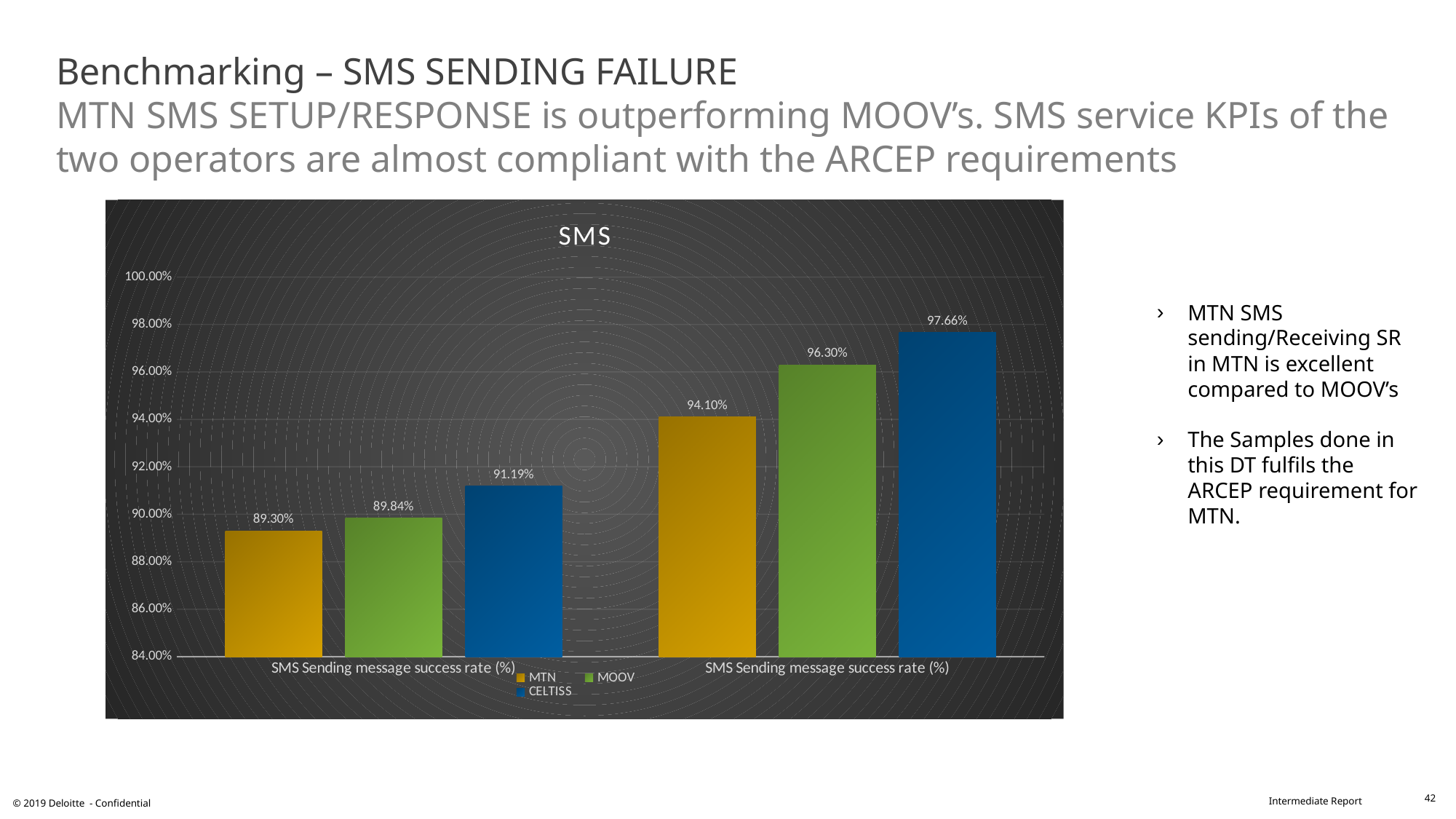
What is the value of the CELTISS bar in the right group of the chart? 97.66% What kind of chart is shown on the slide? bar chart How many series does the chart legend list? 3 What is the title of the chart? SMS Is the MTN value in the right group of the chart greater or less than 92.00%? greater Which series has the lowest bar in the right group of the chart? MTN What is the value of the MOOV bar in the right group of the chart? 96.30% What is the difference between the CELTISS and MTN values in the right group of the chart? 3.56% Which is larger in the left group of the chart: the MOOV value or the CELTISS value? CELTISS Which series has the highest bar in the left group of the chart? CELTISS What is the value of the MTN bar in the left group of the chart? 89.30% Which colour represents the MOOV series in the chart? green